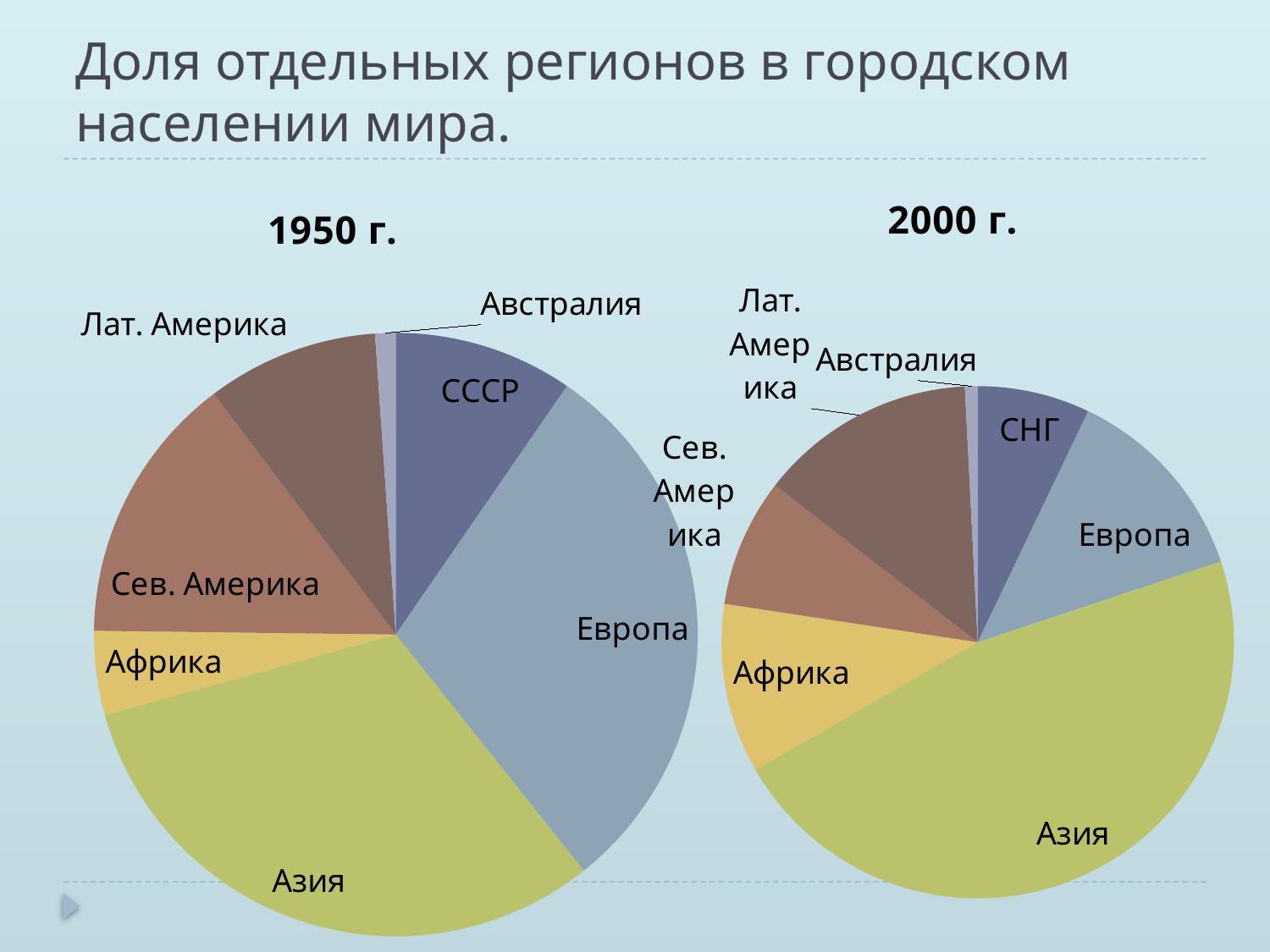
In the "2000 г." pie chart, which region has the smallest share? Австралия In the "1950 г." pie chart, which slice is larger: Африка or Сев. Америка? Сев. Америка How many regions (slices) does the "2000 г." pie chart show? 7 In the "2000 г." pie chart, which region has the largest share? Азия What kind of chart is the "1950 г." chart? pie chart Is the share of Азия larger in the "1950 г." chart or in the "2000 г." chart? 2000 г. What is the title of the slide containing the two pie charts? Доля отдельных регионов в городском населении мира. In the "1950 г." pie chart, which region has the smallest share? Австралия In the "1950 г." pie chart, which region has the largest share? Азия How many regions (slices) does the "1950 г." pie chart show? 7 In the "1950 г." pie chart, which slice is larger: Европа or Сев. Америка? Европа